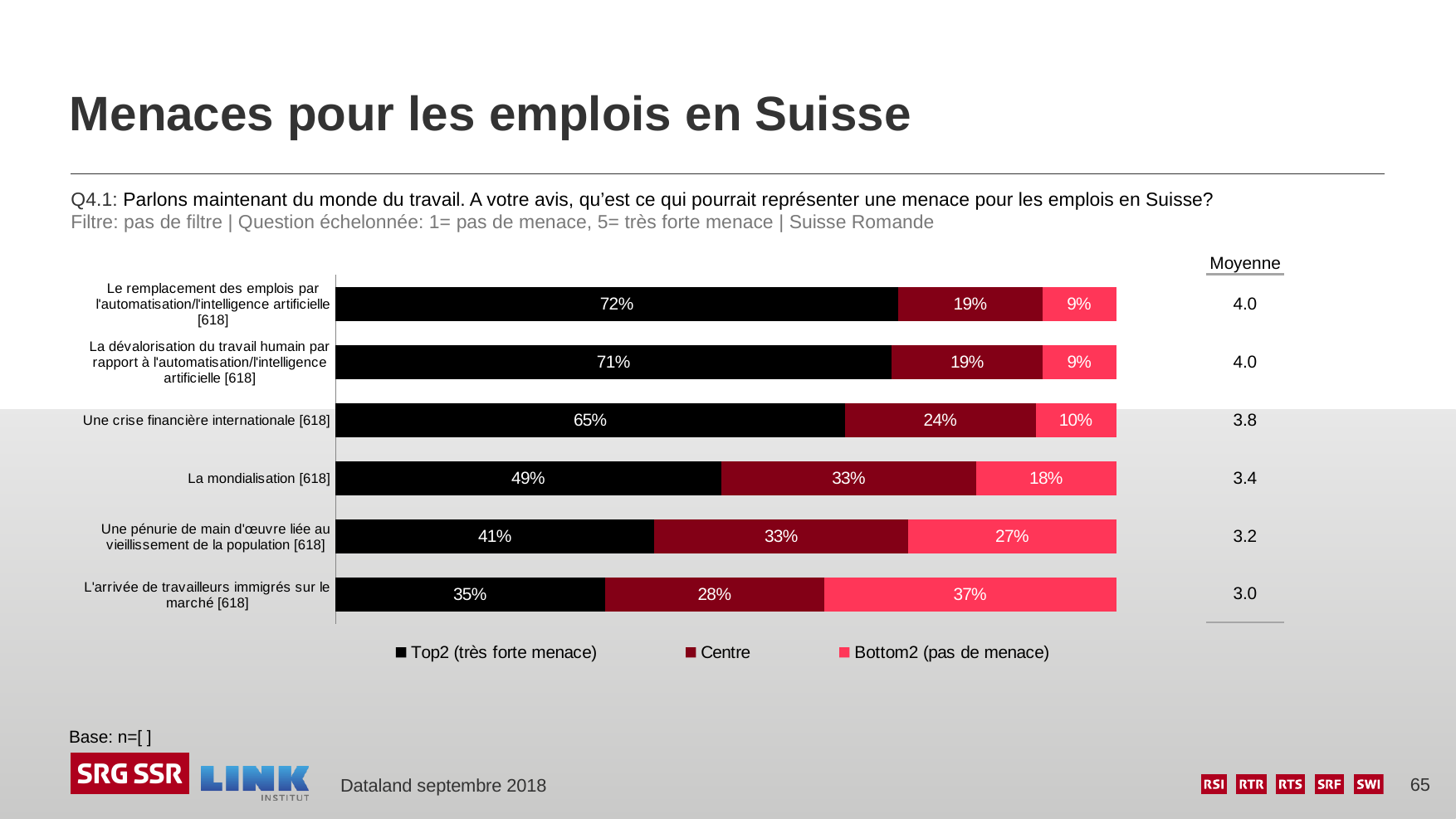
How many series does the legend list? 3 What kind of chart is shown on the slide? Stacked bar chart What is the title of the slide? Menaces pour les emplois en Suisse Which category has the highest Top2 (très forte menace) percentage? Le remplacement des emplois par l'automatisation/l'intelligence artificielle What is the Moyenne (mean) shown for 'Une pénurie de main d'œuvre liée au vieillissement de la population'? 3.2 How many categories are shown in the chart? 6 Which category has the lowest Top2 (très forte menace) percentage? L'arrivée de travailleurs immigrés sur le marché What is the difference between the Top2 values for 'La mondialisation' and 'Une pénurie de main d'œuvre liée au vieillissement de la population'? 8% What is the Centre value for 'La mondialisation'? 33% What is the Bottom2 (pas de menace) value for 'L'arrivée de travailleurs immigrés sur le marché'? 37% What percentage of respondents rated 'Une crise financière internationale' as Top2 (très forte menace)? 65% Which has a larger Bottom2 (pas de menace) value: 'La mondialisation' or 'Une crise financière internationale'? La mondialisation